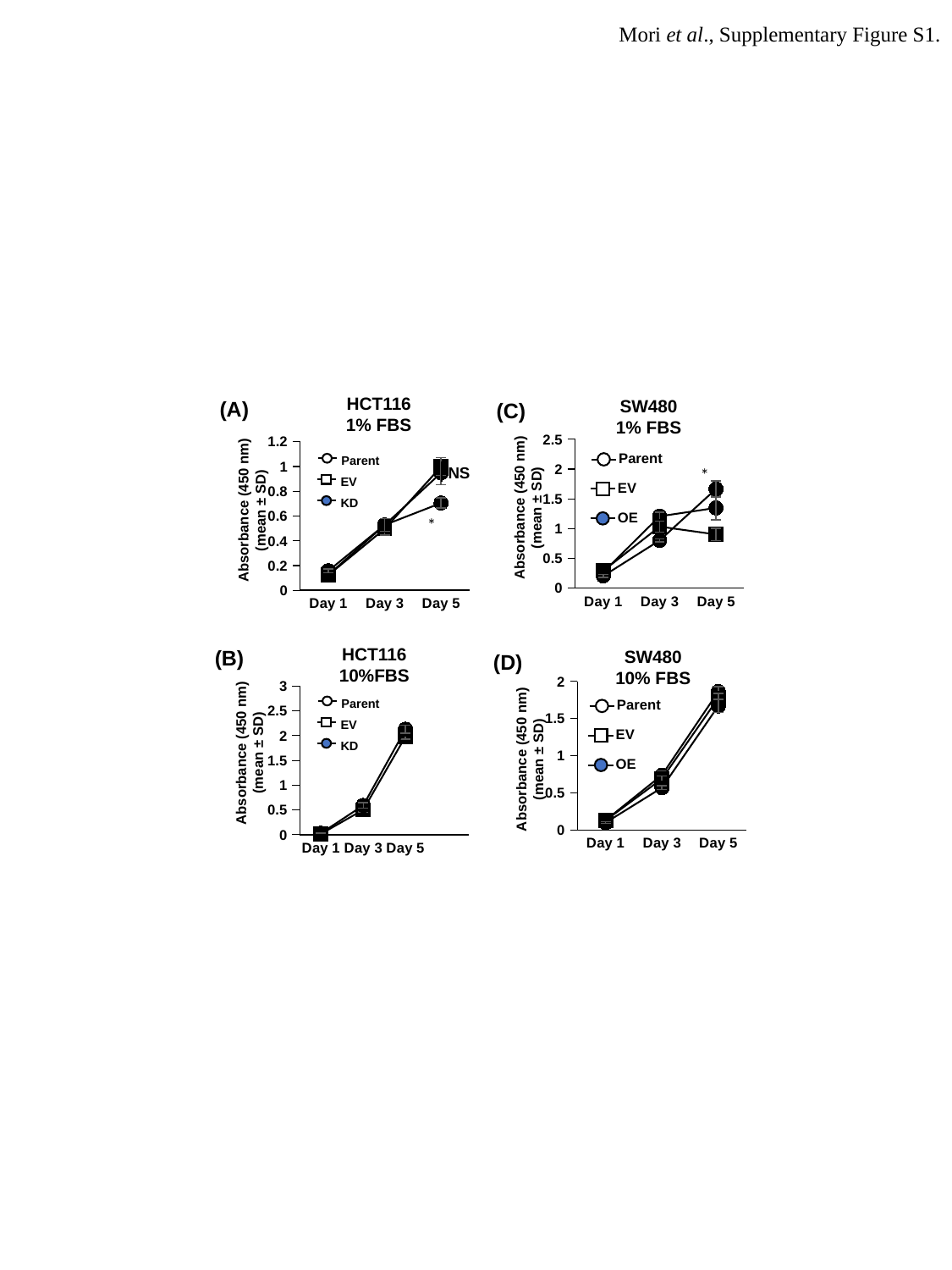
In chart (C), titled SW480 1% FBS, is the OE value at Day 5 greater or less than 1.5? greater How many series does the legend of chart (C), titled SW480 1% FBS, list? 3 In chart (D), titled SW480 10% FBS, do the absorbance values rise or fall from Day 1 to Day 5? rise What is the y-axis label of chart (C), titled SW480 1% FBS? Absorbance (450 nm) (mean ± SD) What kind of chart is chart (A), titled HCT116 1% FBS? line chart In chart (B), titled HCT116 10%FBS, is the Parent value at Day 5 greater or less than 1.5? greater In chart (C), titled SW480 1% FBS, which is larger at Day 5: the OE value or the EV value? OE In chart (A), titled HCT116 1% FBS, which is larger at Day 5: the Parent value or the KD value? Parent Which series in chart (A), titled HCT116 1% FBS, is shown with a filled blue circle marker in the legend? KD How many time points are plotted along the x axis of chart (B), titled HCT116 10%FBS? 3 In chart (D), titled SW480 10% FBS, is the EV value at Day 1 greater or less than 0.5? less